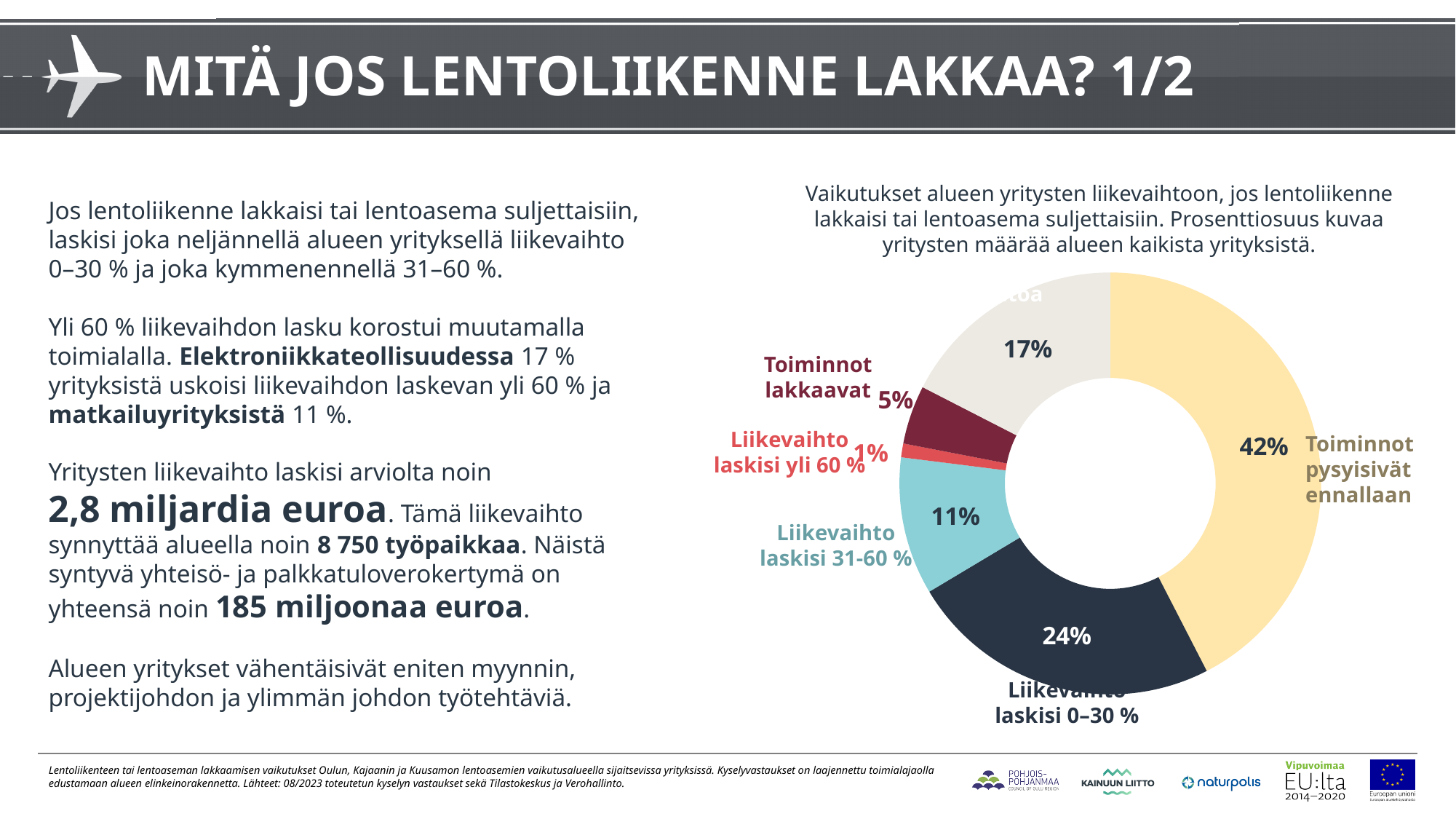
What percentage of companies does the chart show for "Toiminnot pysyisivät ennallaan"? 42% Which is larger: the slice for "Toiminnot lakkaavat" or the slice for "Liikevaihto laskisi 31-60 %"? Liikevaihto laskisi 31-60 % How many slices does the chart have? 6 Which slice of the chart is the smallest? Liikevaihto laskisi yli 60 % Which labelled slice of the chart is the largest? Toiminnot pysyisivät ennallaan What is the difference in percentage points between "Liikevaihto laskisi 31-60 %" and "Toiminnot lakkaavat"? 6 percentage points What value is shown for the "Liikevaihto laskisi 31-60 %" slice? 11% What percentage is shown for "Liikevaihto laskisi yli 60 %"? 1% How many percentage points larger is "Toiminnot pysyisivät ennallaan" than "Liikevaihto laskisi 0–30 %"? 18 percentage points What kind of chart is shown on the slide? Pie (donut) chart What percentage is shown for "Toiminnot lakkaavat"? 5% What share of companies is shown for "Liikevaihto laskisi 0–30 %"? 24%